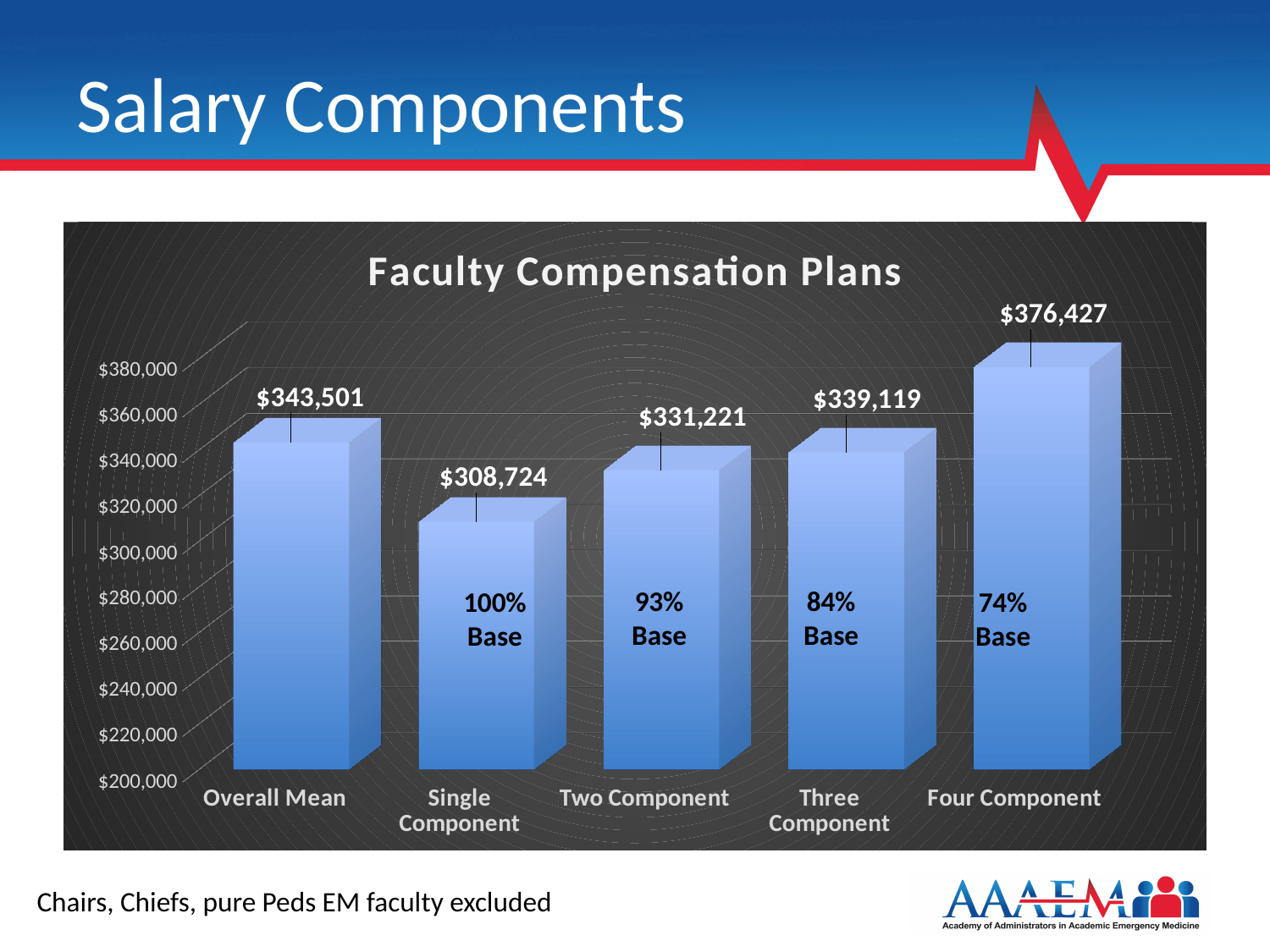
What is the value for Single Component in the Faculty Compensation Plans chart? $308,724 Which category has the lowest value in the Faculty Compensation Plans chart? Single Component Which is larger in the Faculty Compensation Plans chart, Three Component or Two Component? Three Component What is the difference between the Three Component and Two Component values in the Faculty Compensation Plans chart? $7,898 Which category has the highest value in the Faculty Compensation Plans chart? Four Component What kind of chart is the Faculty Compensation Plans chart? Bar chart What is the value for Four Component in the Faculty Compensation Plans chart? $376,427 What base percentage is labelled on the Four Component bar in the Faculty Compensation Plans chart? 74% Base How many categories are shown in the Faculty Compensation Plans chart? 5 What is the value for Two Component in the Faculty Compensation Plans chart? $331,221 What is the Overall Mean value shown in the Faculty Compensation Plans chart? $343,501 What is the difference between the Four Component and Single Component values in the Faculty Compensation Plans chart? $67,703